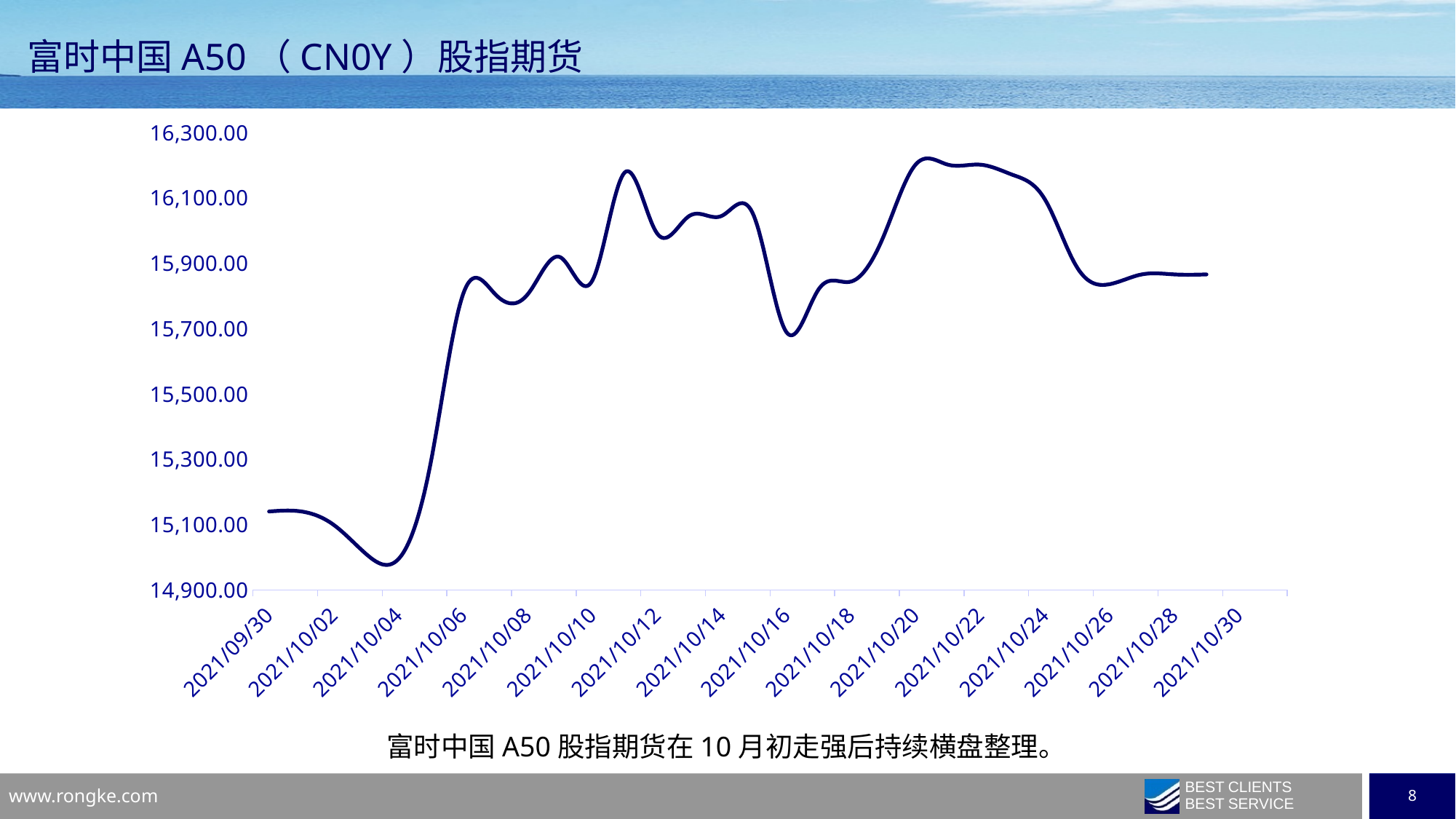
Is the value at 2021/10/20 greater or less than 16,100.00? greater Is the value at 2021/10/26 greater or less than 15,700.00? greater Is the value at 2021/10/04 greater or less than 15,100.00? less What is the title of the chart? 富时中国 A50 （CN0Y） 股指期货 How many date labels are shown on the x axis? 16 Which is larger, the value at 2021/10/04 or the value at 2021/10/20? 2021/10/20 Does the line rise or fall between 2021/10/22 and 2021/10/26? fall Near which x-axis date does the line reach its lowest point? 2021/10/04 Does the line rise or fall between 2021/09/30 and 2021/10/06? rise What is the highest value shown on the y axis? 16,300.00 What kind of chart is shown on the slide? line chart